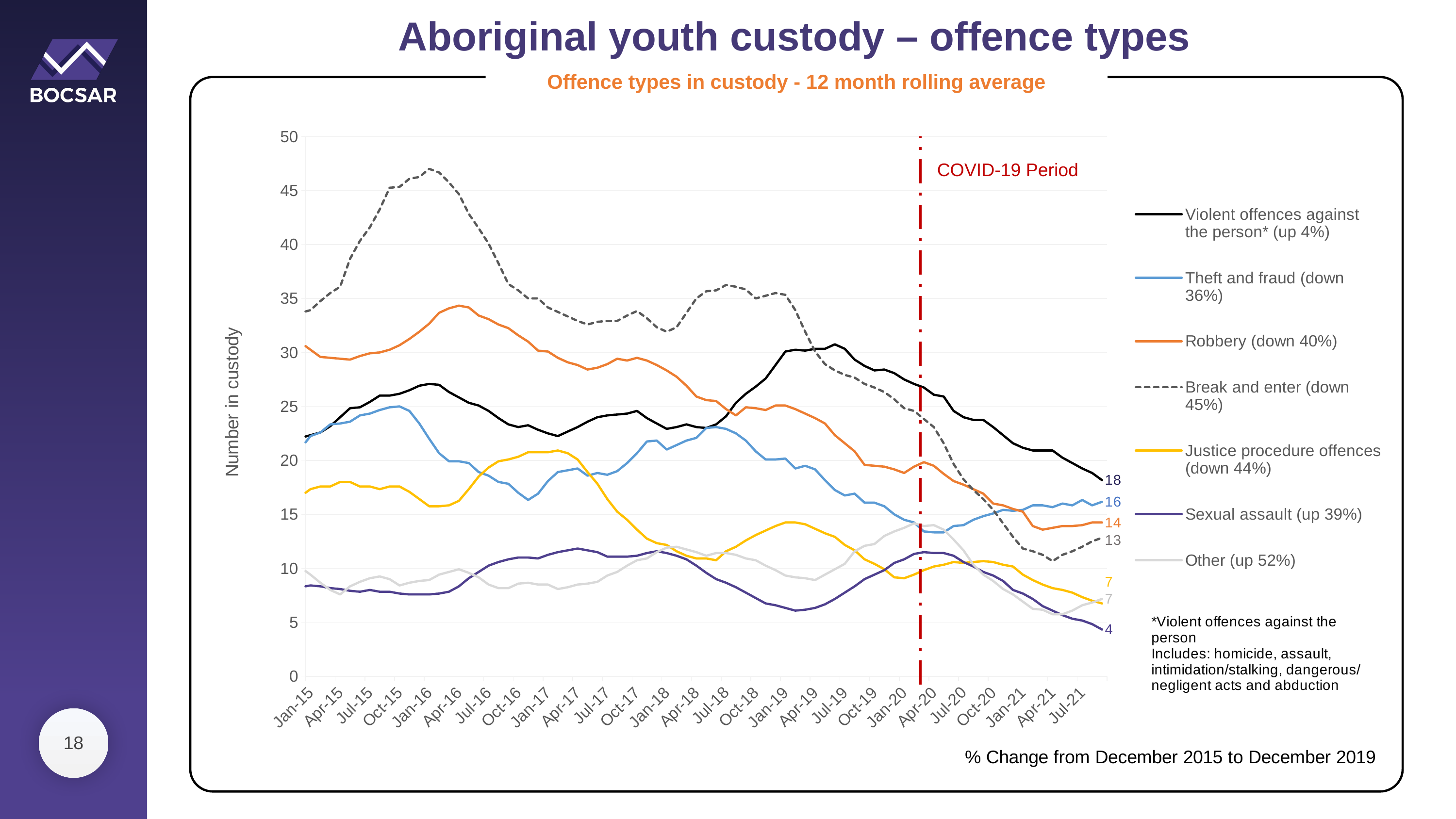
What is the difference between the final labelled values for Violent offences against the person and Theft and fraud? 2 Which series has the lowest value at the end of the chart (Jul-21)? Sexual assault What is the final labelled value for Robbery? 14 What is the final labelled value for Violent offences against the person? 18 Which series has the highest value at the end of the chart (Jul-21)? Violent offences against the person What is the final labelled value for Theft and fraud? 16 Is the value for Break and enter at Jan-16 greater or less than 45? greater What is the final labelled value for Sexual assault? 4 What kind of chart is shown on the slide? line chart What does the red dashed vertical line on the chart mark? COVID-19 Period How many series does the legend list? 7 At the end of the chart, which is larger: Theft and fraud or Robbery? Theft and fraud